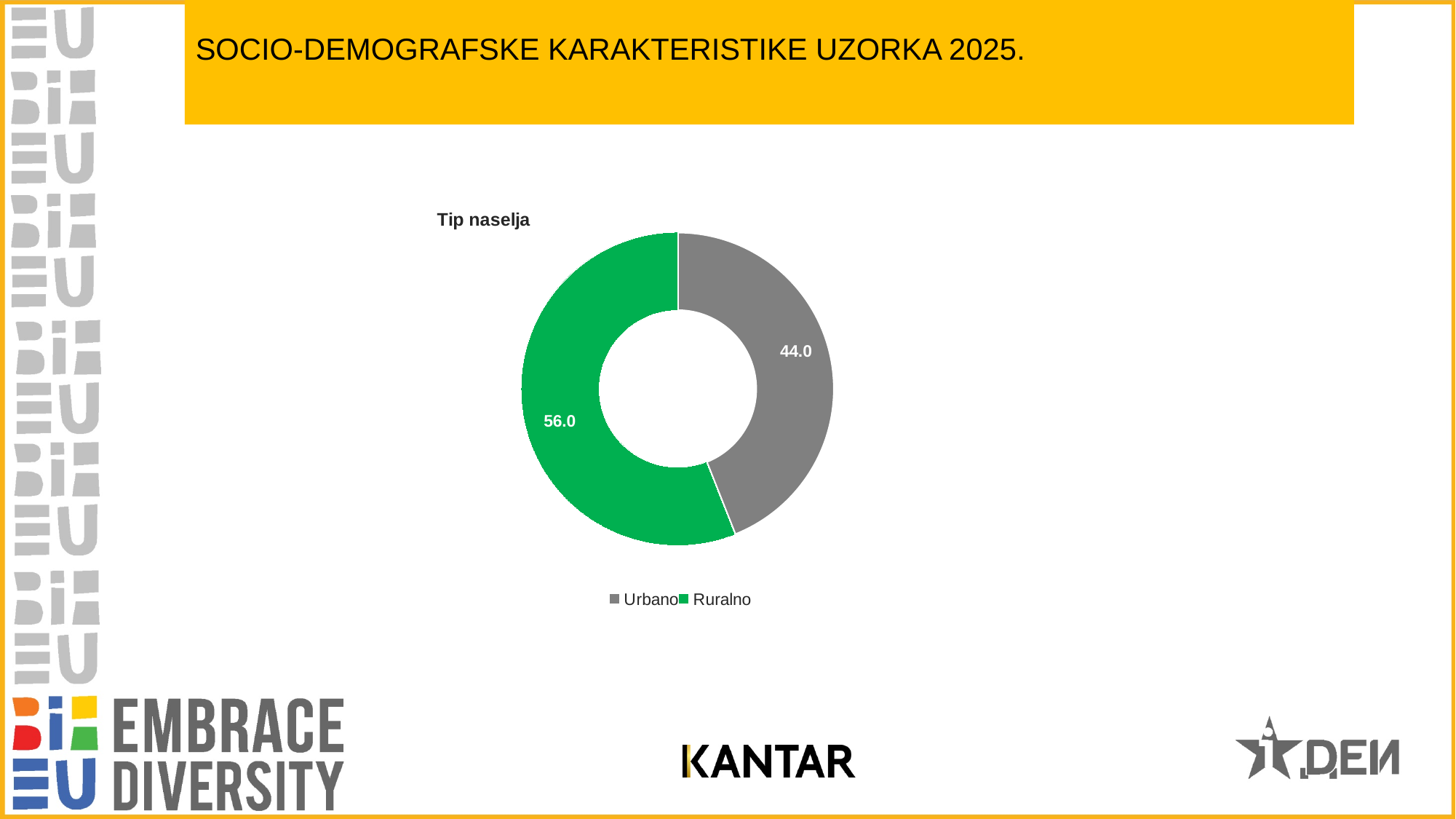
Which colour represents Ruralno in the Tip naselja chart? Green How many categories are shown in the Tip naselja chart? 2 How many entries does the legend of the Tip naselja chart list? 2 What is the total of the two values shown in the Tip naselja chart? 100.0 What is the value for Urbano in the Tip naselja chart? 44.0 What is the title of the chart on the slide? Tip naselja What is the value for Ruralno in the Tip naselja chart? 56.0 Which category has the largest share in the Tip naselja chart? Ruralno What is the difference between the Ruralno and Urbano values in the Tip naselja chart? 12.0 Which category has the smallest share in the Tip naselja chart? Urbano What kind of chart is the Tip naselja chart? Doughnut (pie) chart Which is larger in the Tip naselja chart, Urbano or Ruralno? Ruralno